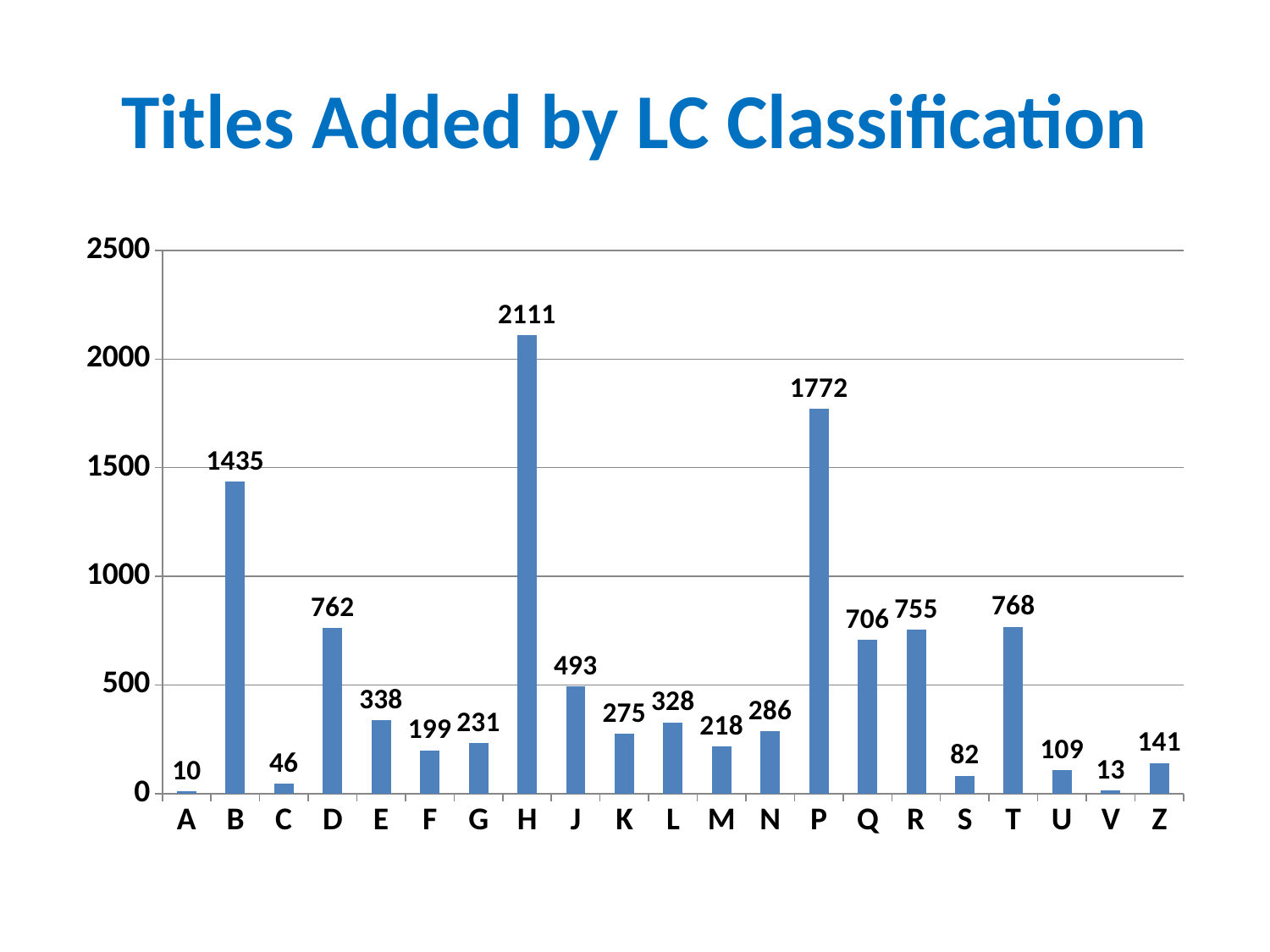
What is the difference between the values for B and D? 673 How many categories are shown on the x axis? 21 Which is larger, the value for T or the value for R? T What is the difference between the values for H and P? 339 Which category has the lowest value? A Which category has the highest value? H What is the title of the chart? Titles Added by LC Classification What kind of chart is shown on the slide? bar chart What is the value for category P? 1772 What is the value for category H? 2111 Is the value for J greater or less than 500? less What is the value for category S? 82